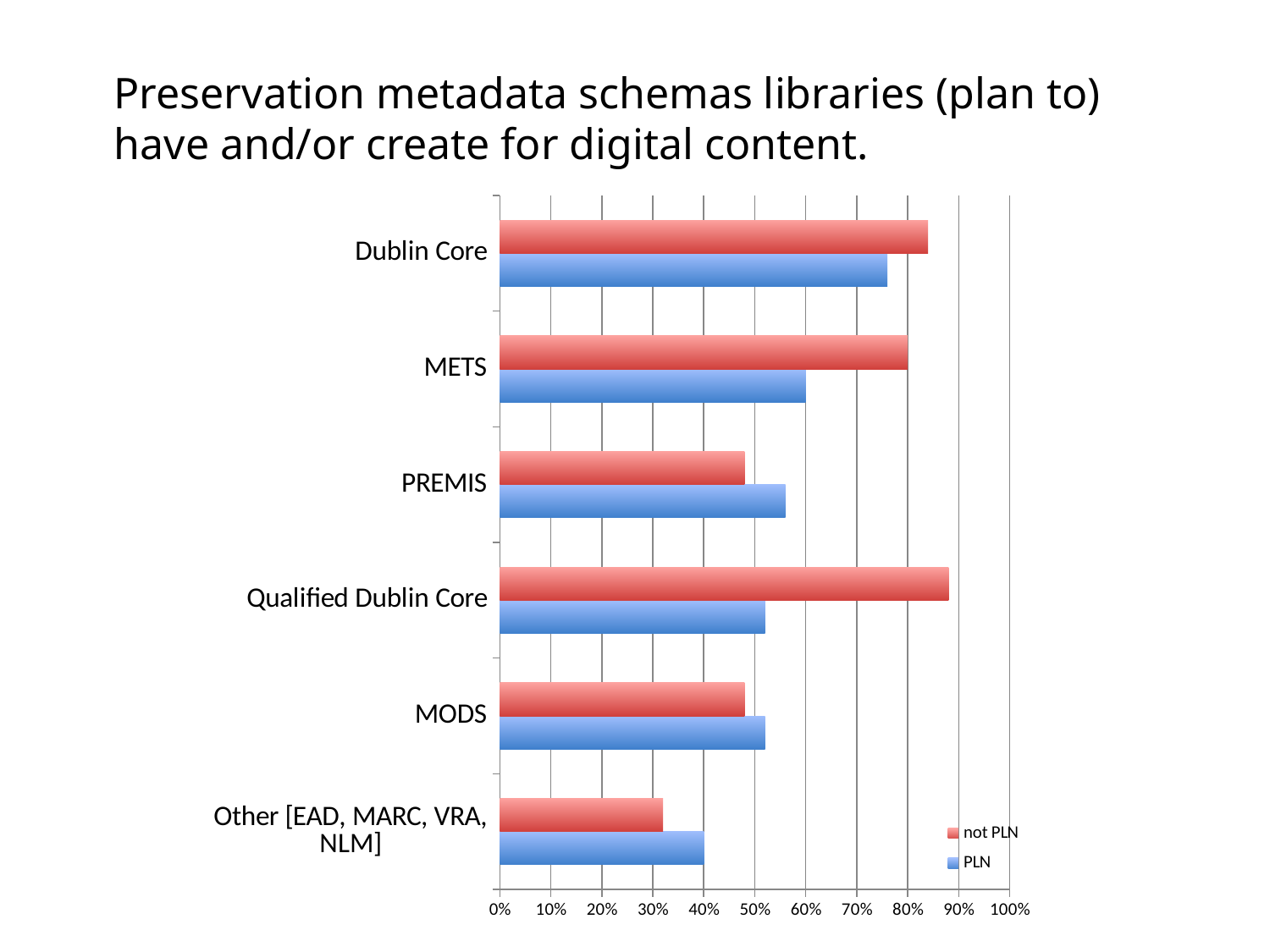
Is the PLN value for Other [EAD, MARC, VRA, NLM] greater or less than 50%? less Is the not PLN value for Qualified Dublin Core greater or less than 80%? greater How many metadata schema categories are shown on the chart? 6 Which series is shown in red in the legend? not PLN Which category has the lowest value for the PLN series? Other [EAD, MARC, VRA, NLM] Which category has the highest value for the PLN series? Dublin Core Which category has the lowest value for the not PLN series? Other [EAD, MARC, VRA, NLM] What kind of chart is shown on the slide? bar chart How many series does the legend list? 2 Which category has the highest value for the not PLN series? Qualified Dublin Core For PREMIS, which series has the larger value, not PLN or PLN? PLN For Dublin Core, which series has the larger value, not PLN or PLN? not PLN